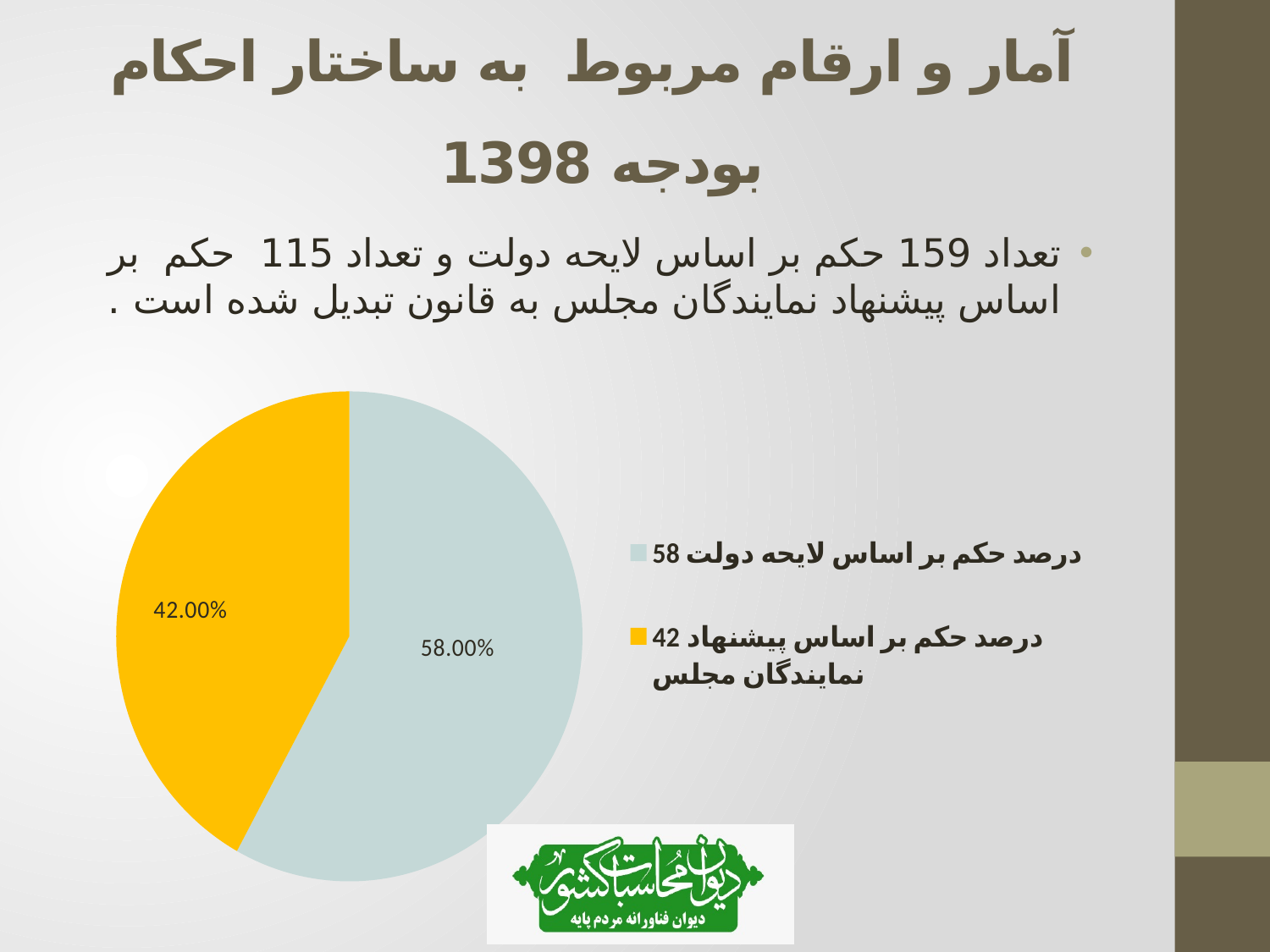
What is the data label on the slice for "درصد حکم بر اساس پیشنهاد نمایندگان مجلس"? 42.00% What colour is the slice labelled 58.00%? light blue How many entries does the legend of the pie chart list? 2 What kind of chart is shown on the slide? pie chart Which slice of the pie chart is the smallest? درصد حکم بر اساس پیشنهاد نمایندگان مجلس How many slices does the pie chart have? 2 Which slice of the pie chart is the largest? درصد حکم بر اساس لایحه دولت What is the difference between the 58.00% slice and the 42.00% slice? 16.00% What share of the pie does the yellow slice represent? 42.00% Which is larger: the slice for "لایحه دولت" or the slice for "پیشنهاد نمایندگان مجلس"? لایحه دولت What colour is the slice for "درصد حکم بر اساس پیشنهاد نمایندگان مجلس"? yellow What is the data label on the slice for "درصد حکم بر اساس لایحه دولت"? 58.00%